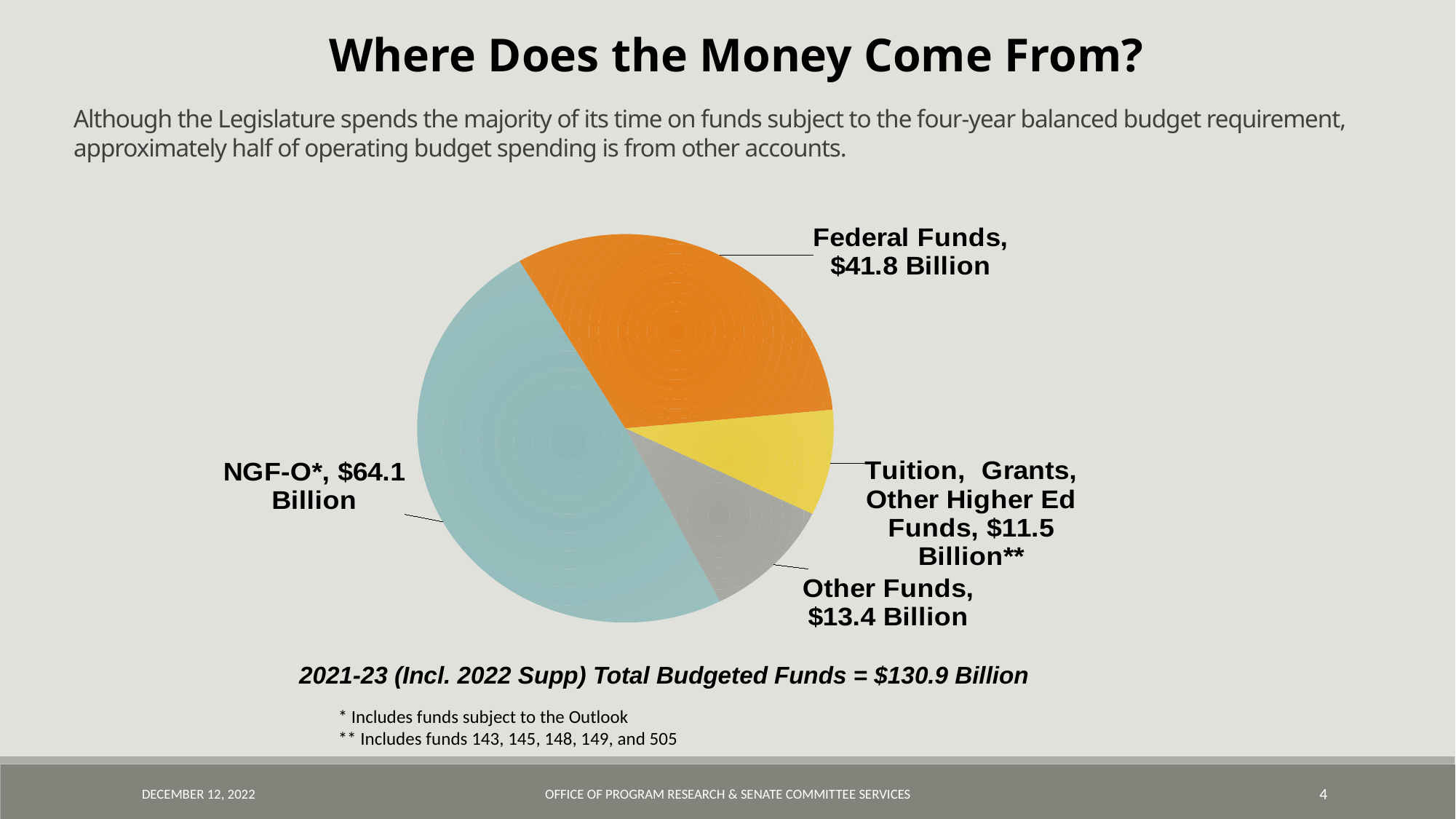
Which is larger, Federal Funds or Other Funds? Federal Funds Which slice of the pie is the smallest? Tuition, Grants, Other Higher Ed Funds What is the difference between Other Funds and Tuition, Grants, Other Higher Ed Funds? $1.9 Billion What is the total budgeted funds shown below the pie chart? $130.9 Billion How many slices does the pie chart have? 4 What is the difference between NGF-O* and Federal Funds? $22.3 Billion What type of chart is shown on the slide? Pie chart What is the value for Other Funds? $13.4 Billion Which slice of the pie is the largest? NGF-O* What is the value for Federal Funds? $41.8 Billion What is the value for NGF-O*? $64.1 Billion What is the value for Tuition, Grants, Other Higher Ed Funds? $11.5 Billion